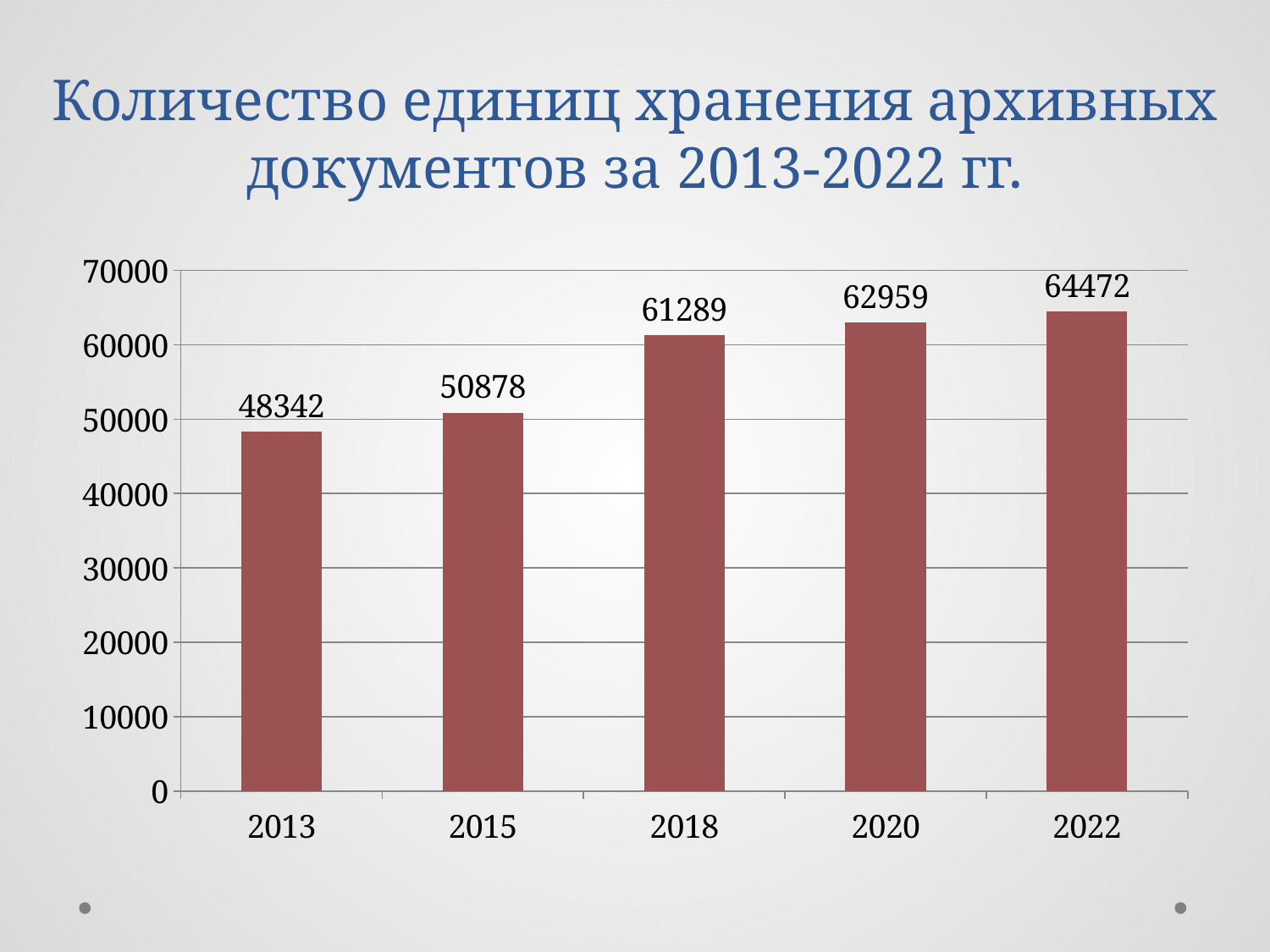
How many years are shown on the x axis? 5 Which year has the highest value? 2022 What is the value for 2013? 48342 What is the difference between the values for 2020 and 2018? 1670 What kind of chart is shown on the slide? bar chart Which year has the lowest value? 2013 Which is larger, the value for 2015 or the value for 2018? 2018 Is the value for 2015 greater or less than 60000? less What is the value for 2022? 64472 What is the value for 2018? 61289 What is the difference between the values for 2022 and 2013? 16130 Do the values rise or fall from 2013 to 2022? rise